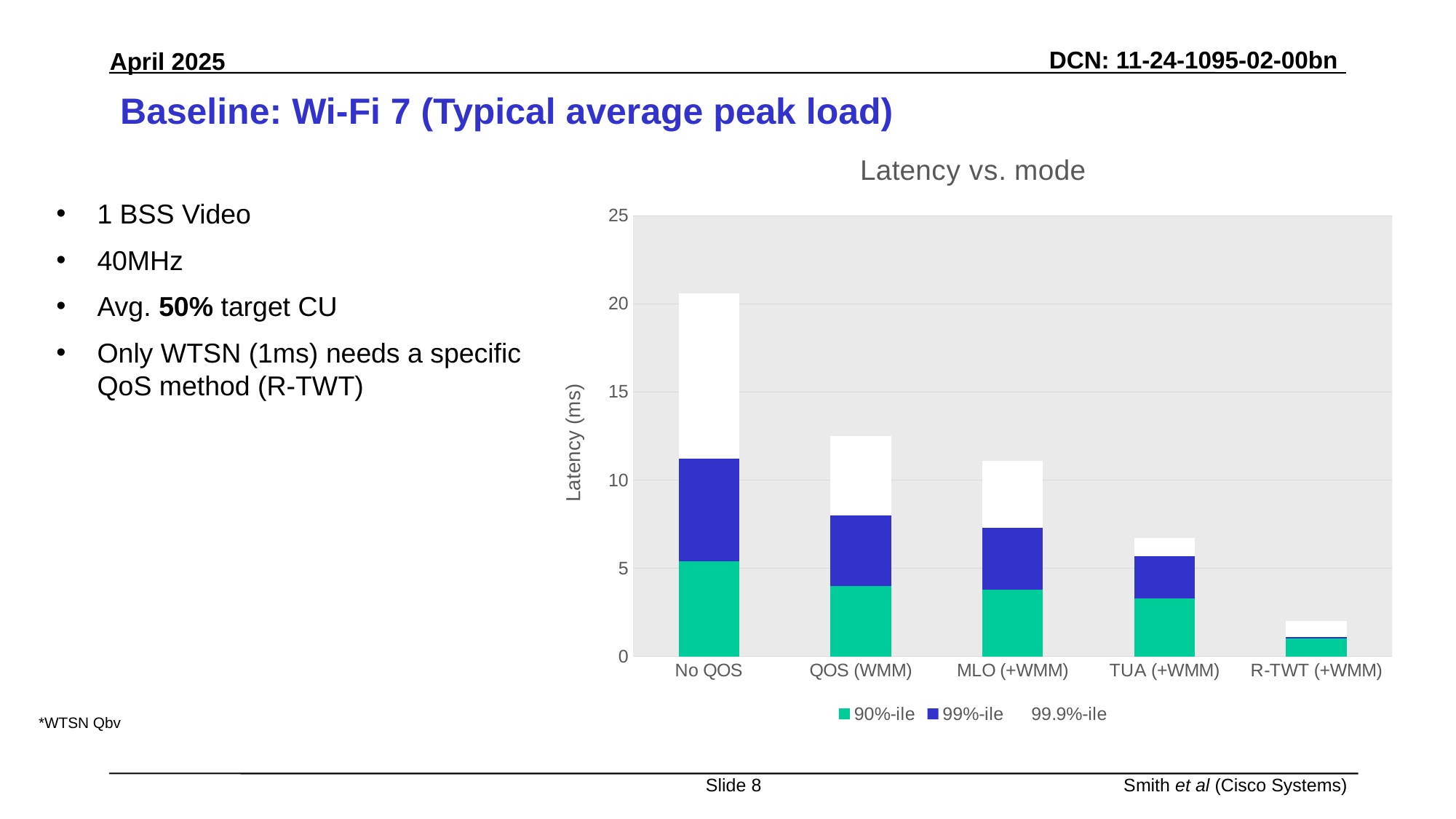
Which mode has the lowest total latency bar? R-TWT (+WMM) Which has a taller total bar, QOS (WMM) or MLO (+WMM)? QOS (WMM) Is the total bar height for QOS (WMM) greater or less than 10? greater Which mode has the highest total latency bar? No QOS How many modes (categories) are shown on the x axis? 5 Is the total bar height for No QOS greater or less than 20? greater Do the total latency bars rise or fall moving from left to right along the x axis? fall What is the label of the y axis? Latency (ms) What is the title of the chart? Latency vs. mode How many series does the legend list? 3 Is the total bar height for R-TWT (+WMM) greater or less than 5? less What kind of chart is shown on the slide? stacked bar chart